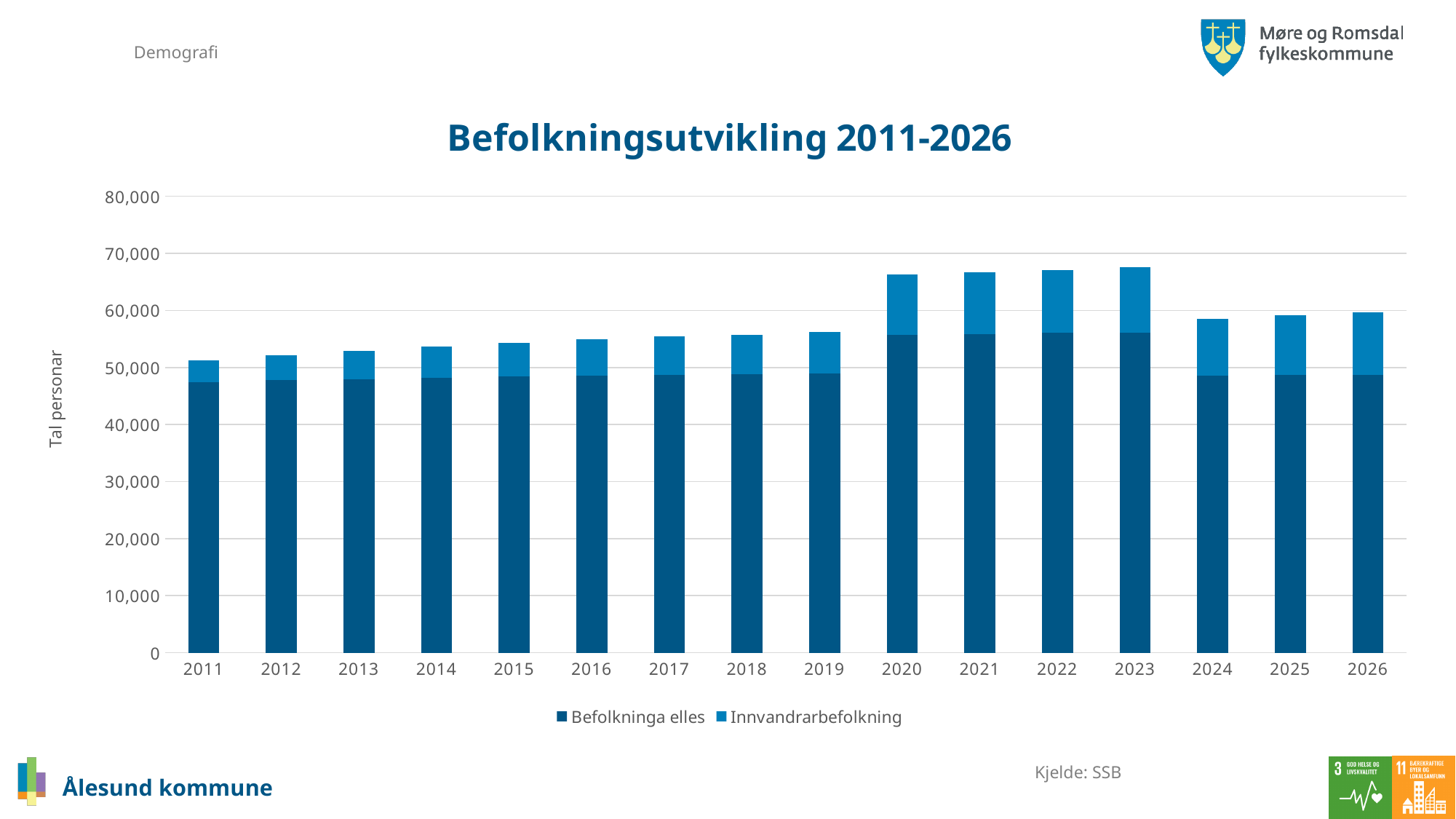
Is the total bar for 2024 greater or less than 60,000? less Which year has the highest total bar in the chart? 2023 Do the total bars rise or fall from 2011 to 2019? rise How many series does the chart's legend list? 2 How many years are shown along the x axis of the chart? 16 What is the title of the chart? Befolkningsutvikling 2011-2026 Is the total bar for 2023 greater or less than 70,000? less Which year has a larger total bar, 2023 or 2024? 2023 What are the two series named in the chart's legend? Befolkninga elles and Innvandrarbefolkning Is the total bar for 2011 greater or less than 50,000? greater What type of chart is shown on the slide? Stacked bar chart Which year has the lowest total bar in the chart? 2011